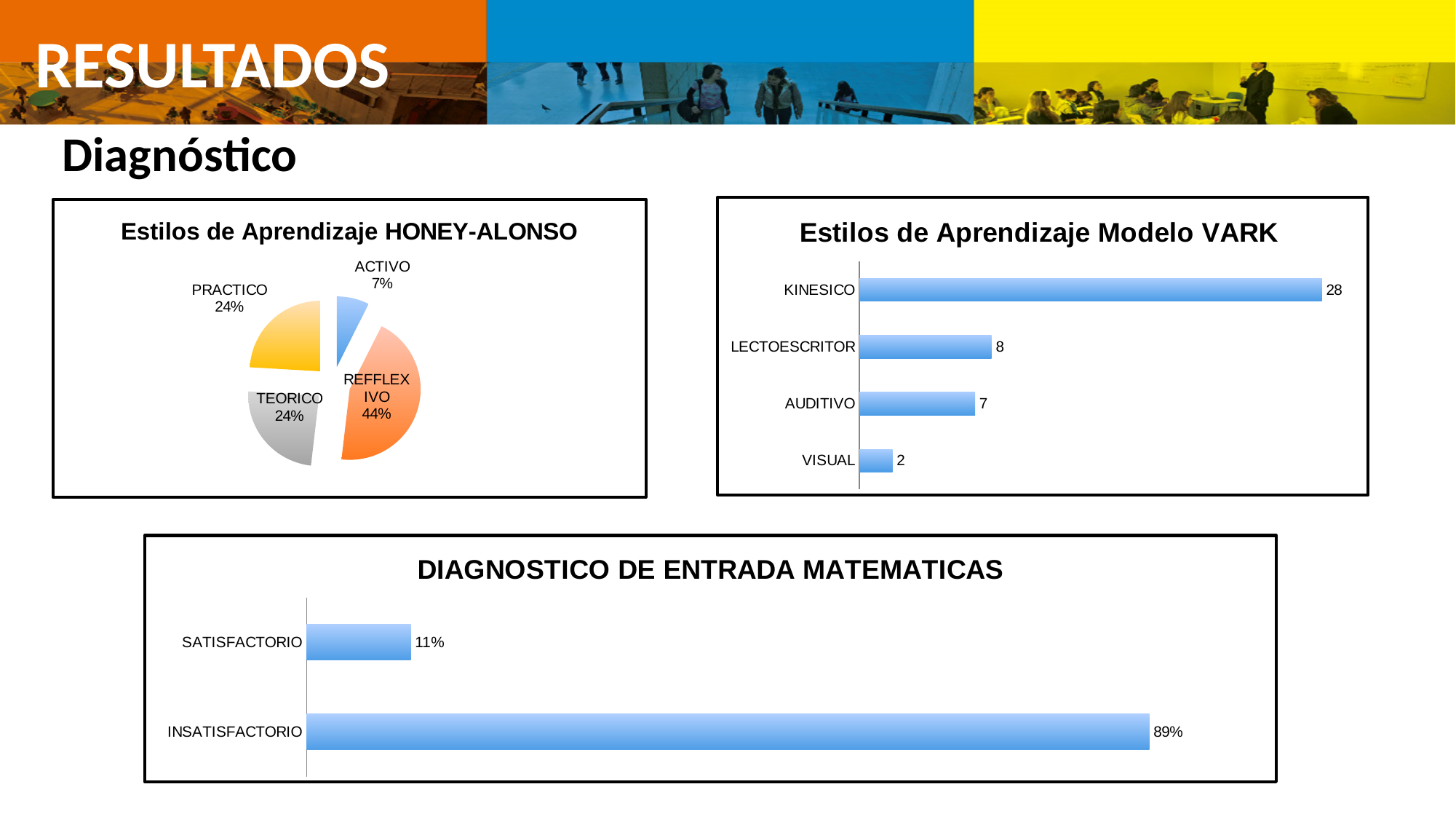
What kind of chart is 'Estilos de Aprendizaje HONEY-ALONSO'? pie chart In the 'Estilos de Aprendizaje HONEY-ALONSO' chart, how many slices does the pie have? 4 In the 'Estilos de Aprendizaje Modelo VARK' chart, which category has the lowest value? VISUAL What kind of chart is 'Estilos de Aprendizaje Modelo VARK'? bar chart In the 'DIAGNOSTICO DE ENTRADA MATEMATICAS' chart, what is the value for INSATISFACTORIO? 89% In the 'Estilos de Aprendizaje Modelo VARK' chart, what is the difference between KINESICO and LECTOESCRITOR? 20 In the 'DIAGNOSTICO DE ENTRADA MATEMATICAS' chart, which category has the highest value? INSATISFACTORIO In the 'Estilos de Aprendizaje HONEY-ALONSO' chart, which learning style has the smallest slice? ACTIVO In the 'Estilos de Aprendizaje Modelo VARK' chart, what is the value for KINESICO? 28 In the 'DIAGNOSTICO DE ENTRADA MATEMATICAS' chart, how many categories are shown? 2 In the 'Estilos de Aprendizaje HONEY-ALONSO' chart, what share does REFFLEXIVO have? 44% In the 'Estilos de Aprendizaje Modelo VARK' chart, which is larger, LECTOESCRITOR or AUDITIVO? LECTOESCRITOR